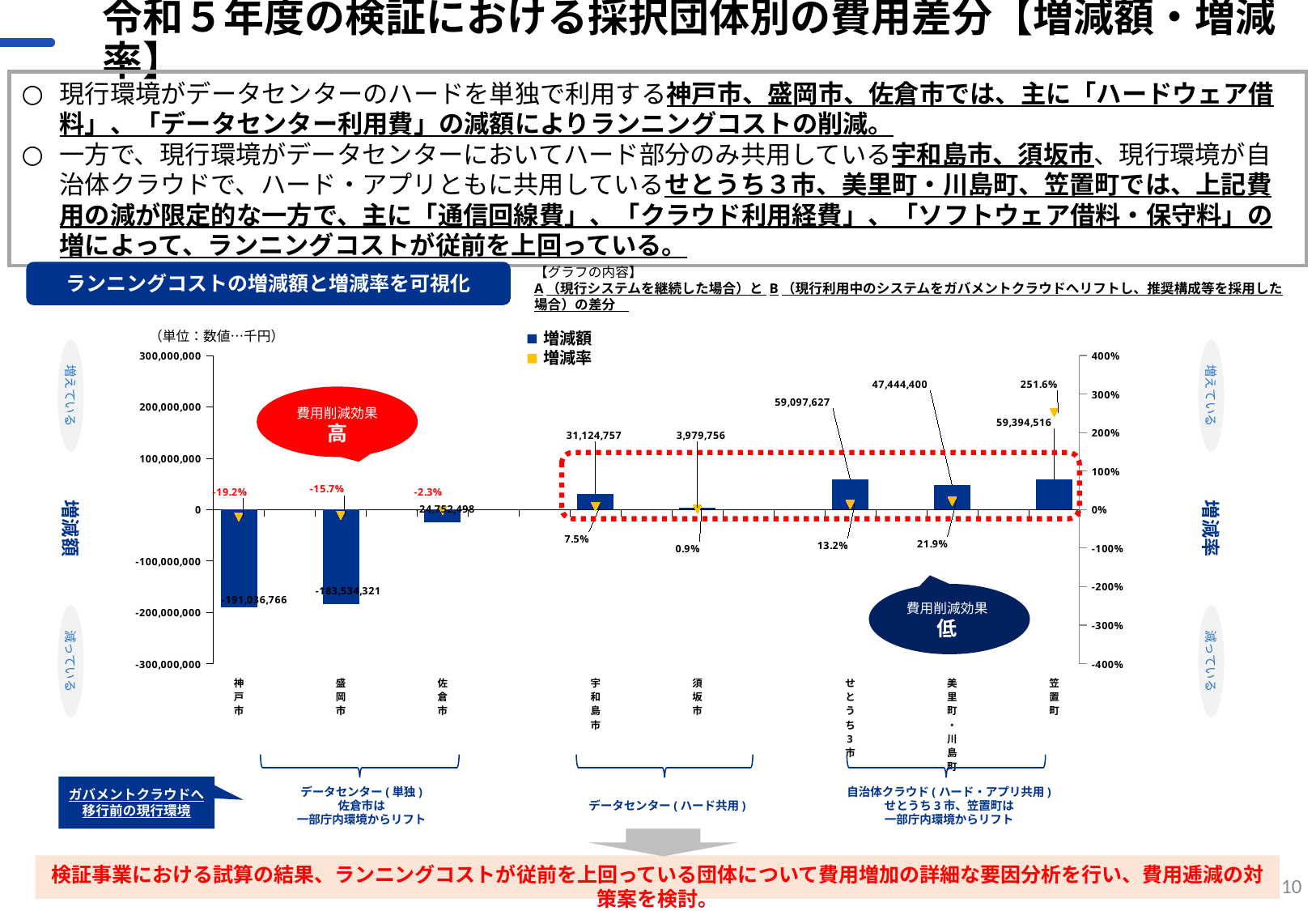
How many series does the chart legend list? 2 Which category has the lowest 増減額? 神戸市 What colour is used for the 増減率 series in the legend? Yellow What is the 増減率 value for 盛岡市? -15.7% What is the 増減額 value for 美里町・川島町? 47,444,400 What is the 増減率 value for 笠置町? 251.6% Which category has the highest 増減率? 笠置町 What is the difference between the 増減額 values of 神戸市 and 盛岡市? 7,502,445 What is the 増減額 value for 神戸市? -191,036,766 Which has the larger 増減額, 宇和島市 or 須坂市? 宇和島市 Is the 増減額 value for せとうち3市 greater or less than 100,000,000? less How many categories (municipalities) are shown on the x axis of the chart? 8